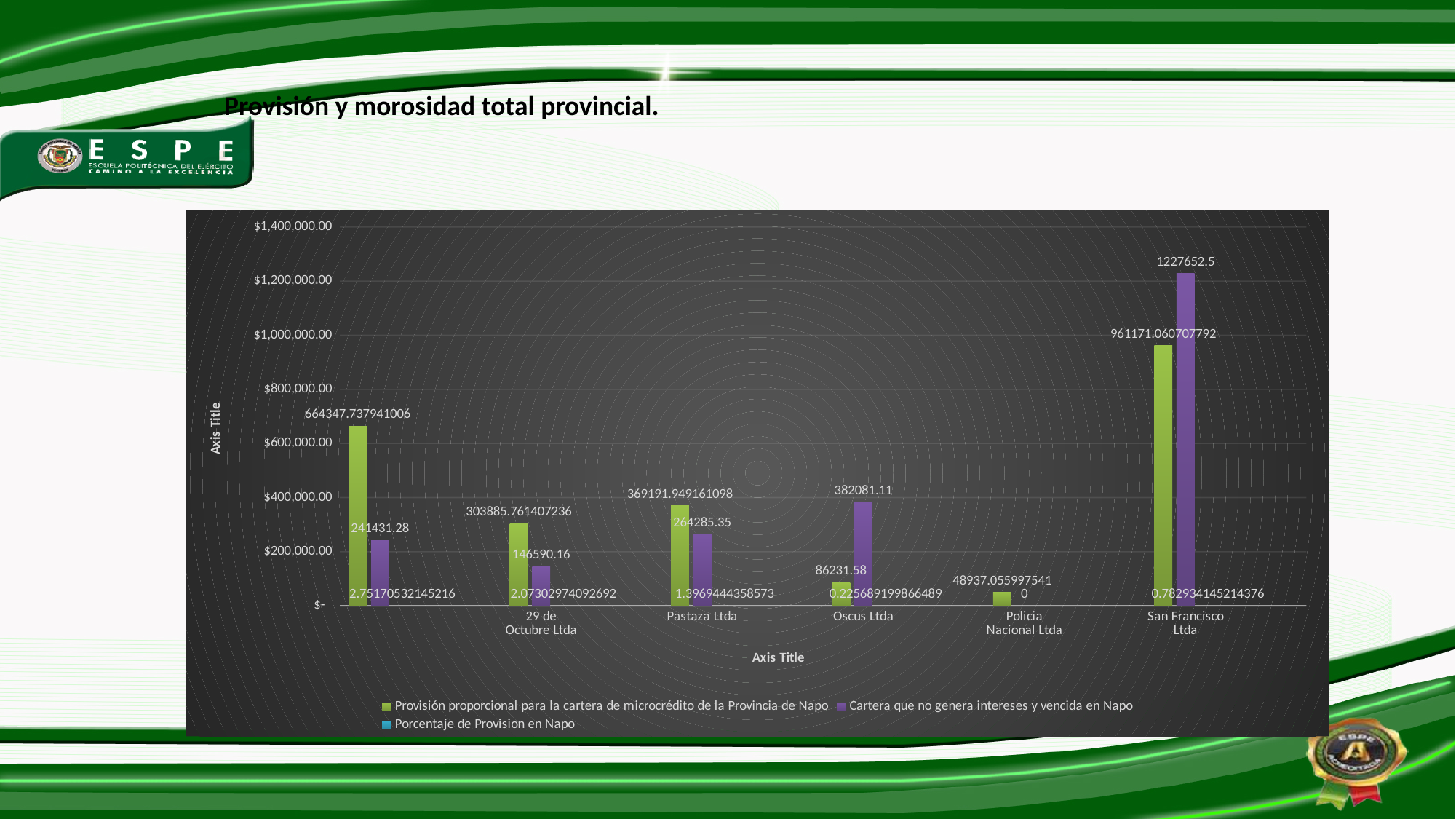
What is the title of the slide above the chart? Provisión y morosidad total provincial. What is the value of 'Provisión proporcional para la cartera de microcrédito de la Provincia de Napo' for San Francisco Ltda? 961171.060707792 What is the value of 'Porcentaje de Provision en Napo' for 29 de Octubre Ltda? 2.07302974092692 For San Francisco Ltda, what is the difference between 'Cartera que no genera intereses y vencida en Napo' and 'Provisión proporcional para la cartera de microcrédito de la Provincia de Napo'? 266481.439292208 Which category has the lowest value for 'Provisión proporcional para la cartera de microcrédito de la Provincia de Napo'? Policia Nacional Ltda What is the value of 'Cartera que no genera intereses y vencida en Napo' for Policia Nacional Ltda? 0 Which category has the highest value for 'Cartera que no genera intereses y vencida en Napo'? San Francisco Ltda What is the value of 'Cartera que no genera intereses y vencida en Napo' for Oscus Ltda? 382081.11 How many series does the legend list? 3 What kind of chart is shown on the slide? bar chart For Pastaza Ltda, which is larger: 'Provisión proporcional para la cartera de microcrédito de la Provincia de Napo' or 'Cartera que no genera intereses y vencida en Napo'? Provisión proporcional para la cartera de microcrédito de la Provincia de Napo Is the value of 'Provisión proporcional para la cartera de microcrédito de la Provincia de Napo' for Policia Nacional Ltda greater or less than $200,000.00? less